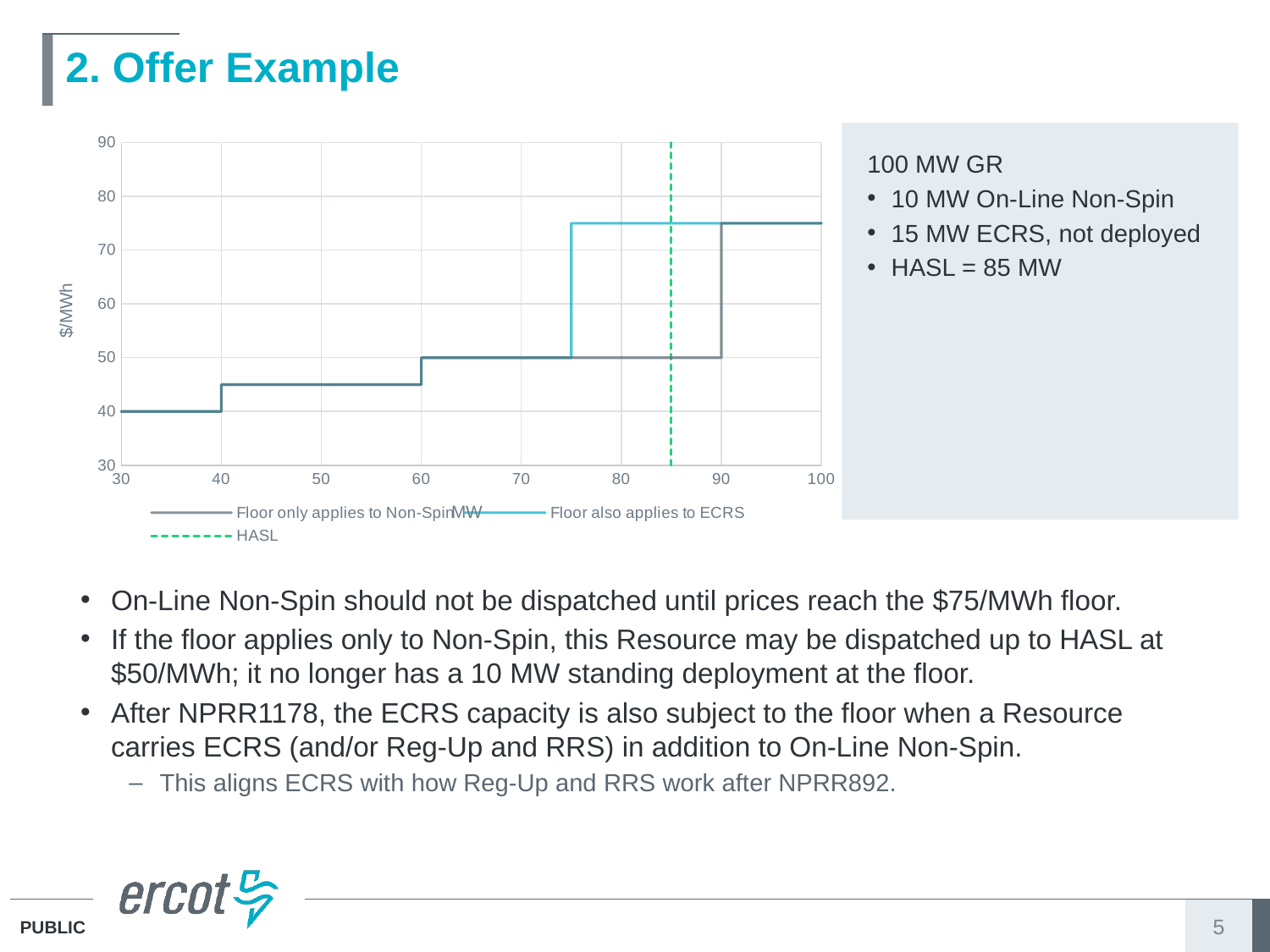
Do the values of the 'Floor only applies to Non-Spin' series rise or fall as MW increases along the x axis? rise Which legend entry is drawn as a dashed line? HASL Is the value of the 'Floor only applies to Non-Spin' series at 95 MW greater or less than 70? greater What is the label on the vertical axis of the chart? $/MWh Is the value of the 'Floor also applies to ECRS' series at 80 MW greater or less than 70? greater What is the value of the 'Floor only applies to Non-Spin' series at 35 MW? 40 What is the value of the 'Floor also applies to ECRS' series at 65 MW? 50 Is the vertical HASL line positioned at a MW value greater or less than 80? greater What kind of chart is shown on the slide? line chart How many series does the chart legend list? 3 At 80 MW, which series has the higher value: 'Floor only applies to Non-Spin' or 'Floor also applies to ECRS'? Floor also applies to ECRS